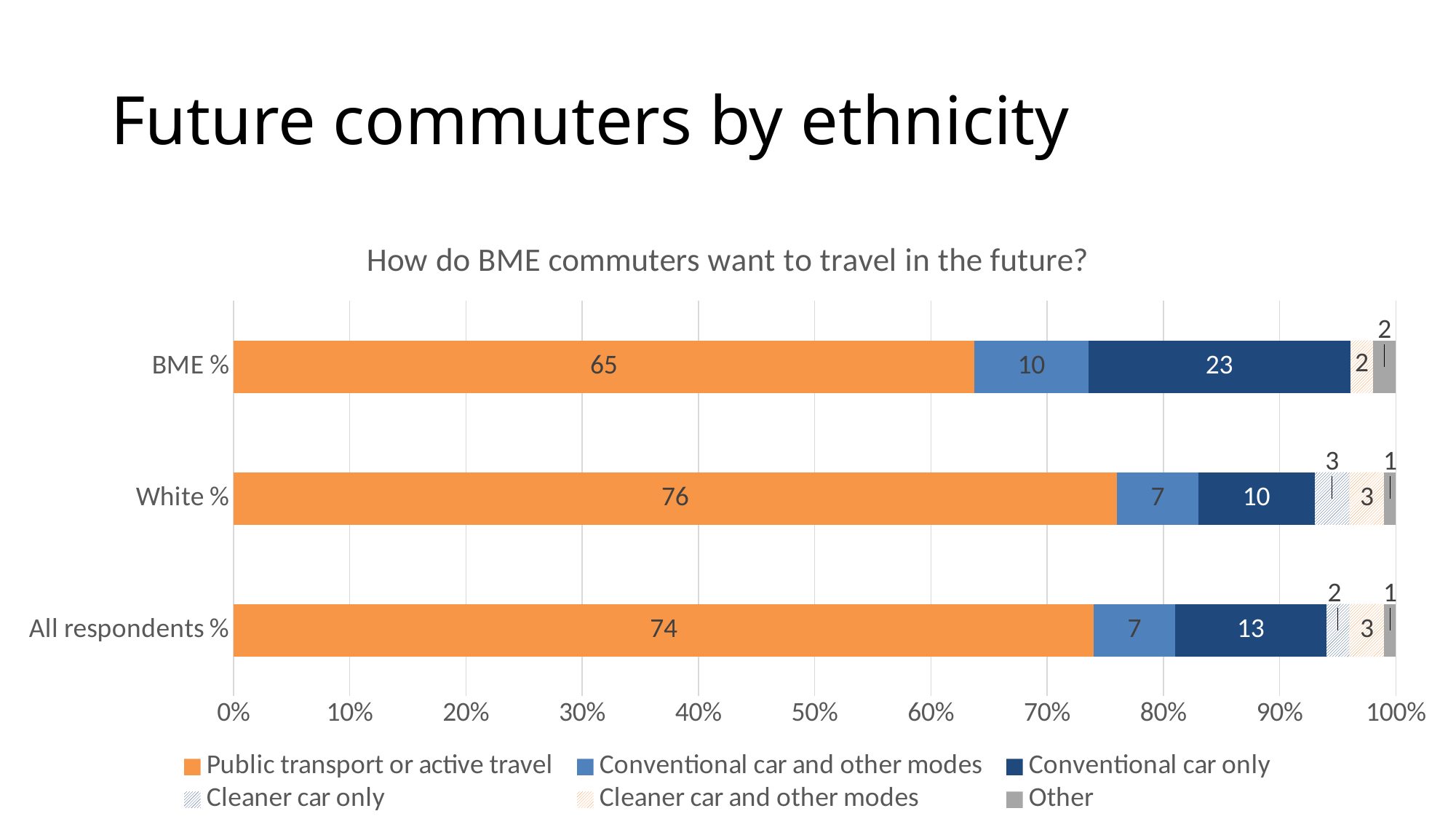
What is the value for Conventional car only for All respondents %? 13 What is the value for Conventional car and other modes for All respondents %? 7 What kind of chart is shown on the slide? Stacked bar chart Which category has the lowest value for Conventional car only? White % Which is larger: the Conventional car and other modes value for BME % or for White %? BME % How many categories are shown on the y axis? 3 Which category has the highest value for Public transport or active travel? White % What is the value for Public transport or active travel for White %? 76 What is the difference between the Conventional car only values for BME % and White %? 13 What is the value for Conventional car only for BME %? 23 How many series does the legend list? 6 What is the value for Public transport or active travel for BME %? 65